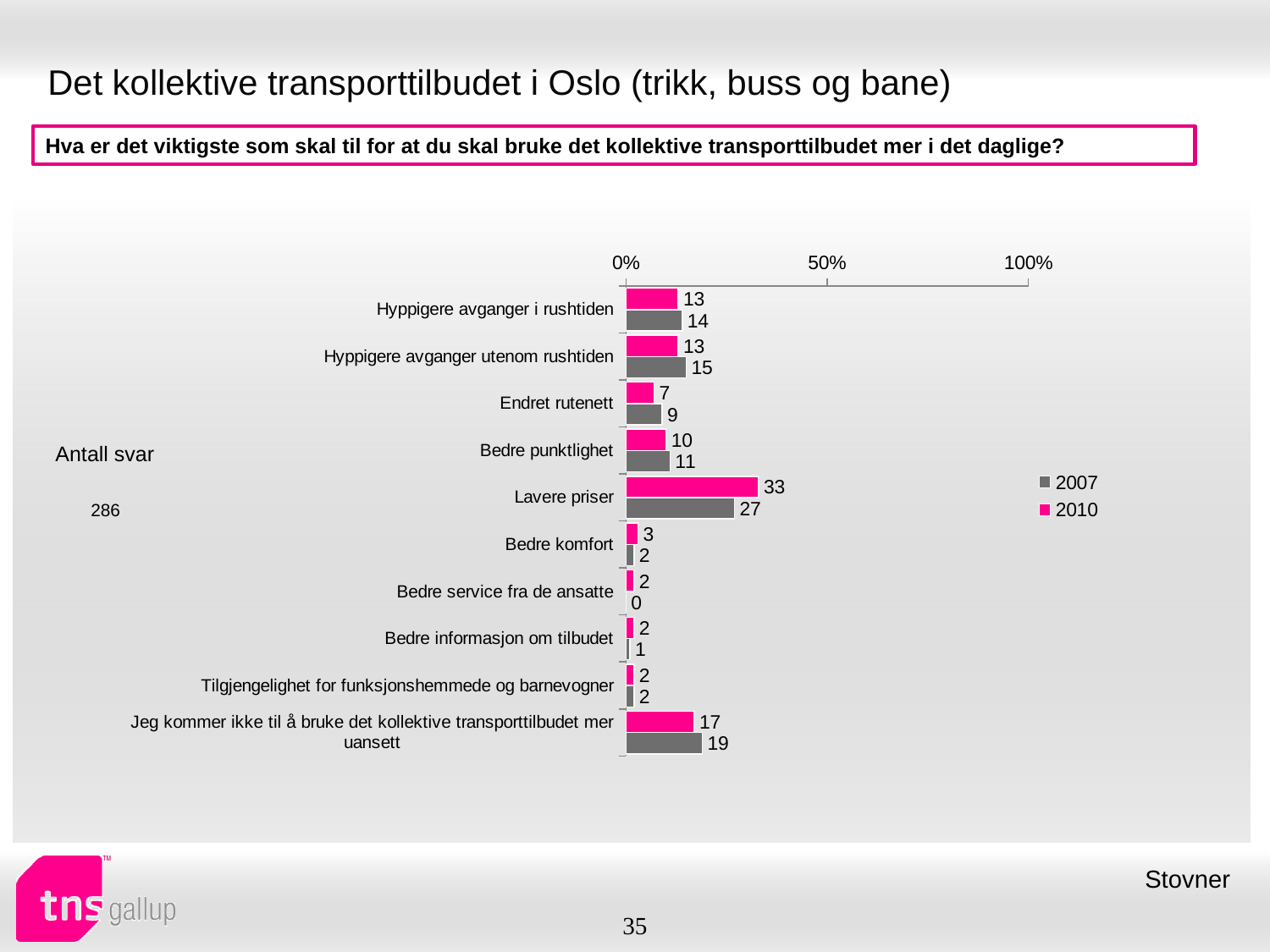
What is the difference between the 2010 and 2007 values for Lavere priser? 6 What is the 2007 value for Bedre service fra de ansatte? 0 What kind of chart is shown on the slide? bar chart How many categories are shown on the chart? 10 Which category has the lowest 2007 value? Bedre service fra de ansatte Which colour represents the 2010 series in the legend? pink What is the 2010 value for Lavere priser? 33 Is the 2010 value for Lavere priser greater or less than 50%? less How many series does the legend list? 2 For Endret rutenett, which year has the larger value, 2007 or 2010? 2007 What is the 2007 value for Hyppigere avganger utenom rushtiden? 15 Which category has the highest 2010 value? Lavere priser